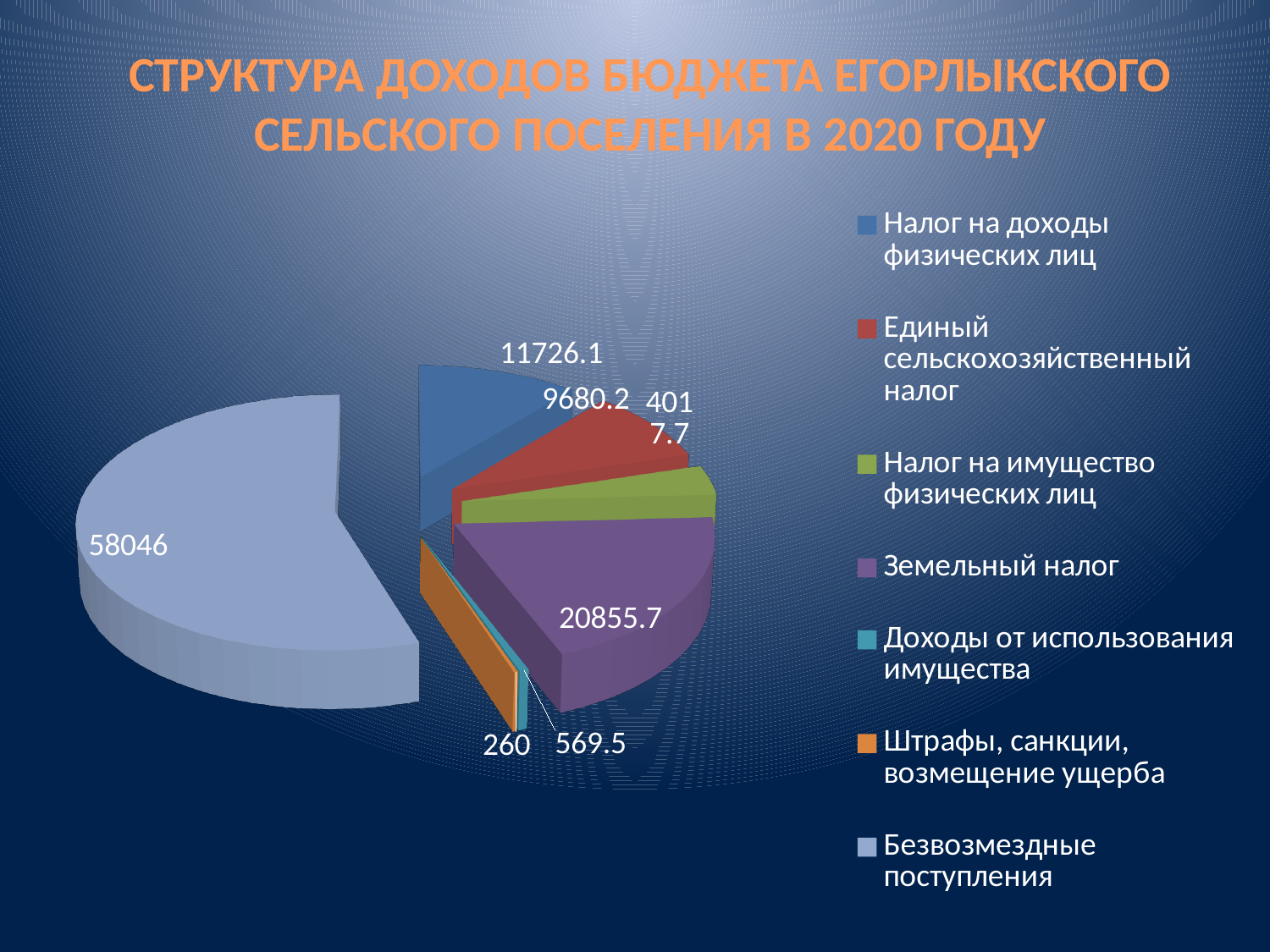
What is the difference between the values for Земельный налог and Налог на доходы физических лиц? 9129.6 Which is larger: Земельный налог or Безвозмездные поступления? Безвозмездные поступления What kind of chart is shown on the slide? Pie chart What is the difference between the values for Налог на доходы физических лиц and Единый сельскохозяйственный налог? 2045.9 What is the title of the slide? СТРУКТУРА ДОХОДОВ БЮДЖЕТА ЕГОРЛЫКСКОГО СЕЛЬСКОГО ПОСЕЛЕНИЯ В 2020 ГОДУ Which is larger: Налог на доходы физических лиц or Единый сельскохозяйственный налог? Налог на доходы физических лиц What is the value shown for Безвозмездные поступления? 58046 What is the value shown for Налог на доходы физических лиц? 11726.1 What is the value shown for Единый сельскохозяйственный налог? 9680.2 What is the value shown for Земельный налог? 20855.7 Which category has the largest slice of the pie? Безвозмездные поступления How many categories does the legend of the pie chart list? 7